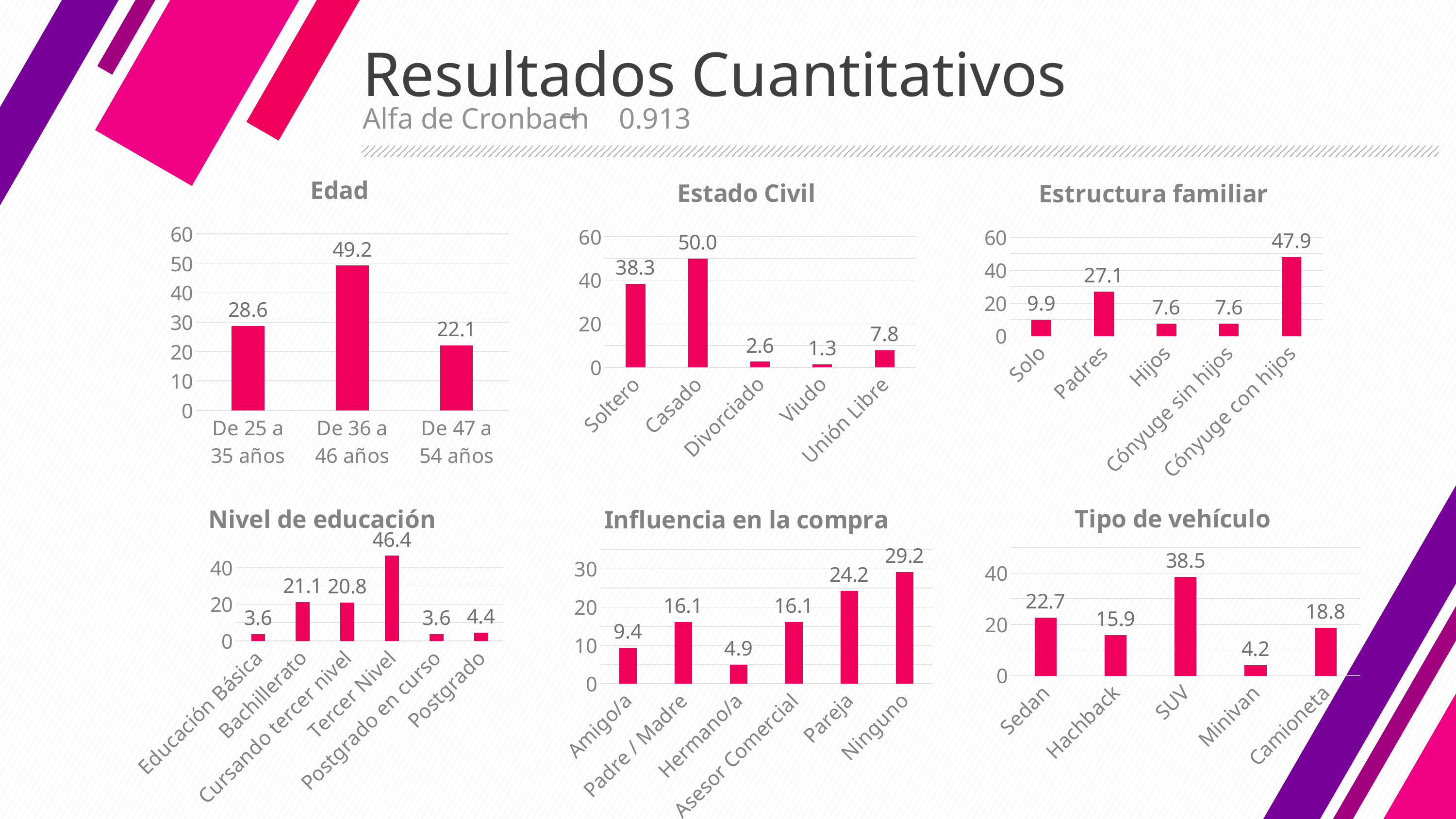
In the 'Estructura familiar' chart, what is the difference between 'Padres' and 'Solo'? 17.2 In the 'Tipo de vehículo' chart, what is the difference between 'SUV' and 'Sedan'? 15.8 In the 'Influencia en la compra' chart, what is the value for 'Hermano/a'? 4.9 In the 'Tipo de vehículo' chart, which category has the lowest value? Minivan In the 'Estado Civil' chart, which category has the lowest value? Viudo In the 'Estado Civil' chart, which category has the highest value? Casado In the 'Nivel de educación' chart, how many categories are shown? 6 What kind of chart is the 'Edad' chart? Bar chart In the 'Influencia en la compra' chart, which category has the highest value? Ninguno In the 'Edad' chart, what is the value for 'De 36 a 46 años'? 49.2 In the 'Nivel de educación' chart, which is larger, 'Bachillerato' or 'Postgrado'? Bachillerato In the 'Estructura familiar' chart, what is the value for 'Cónyuge con hijos'? 47.9